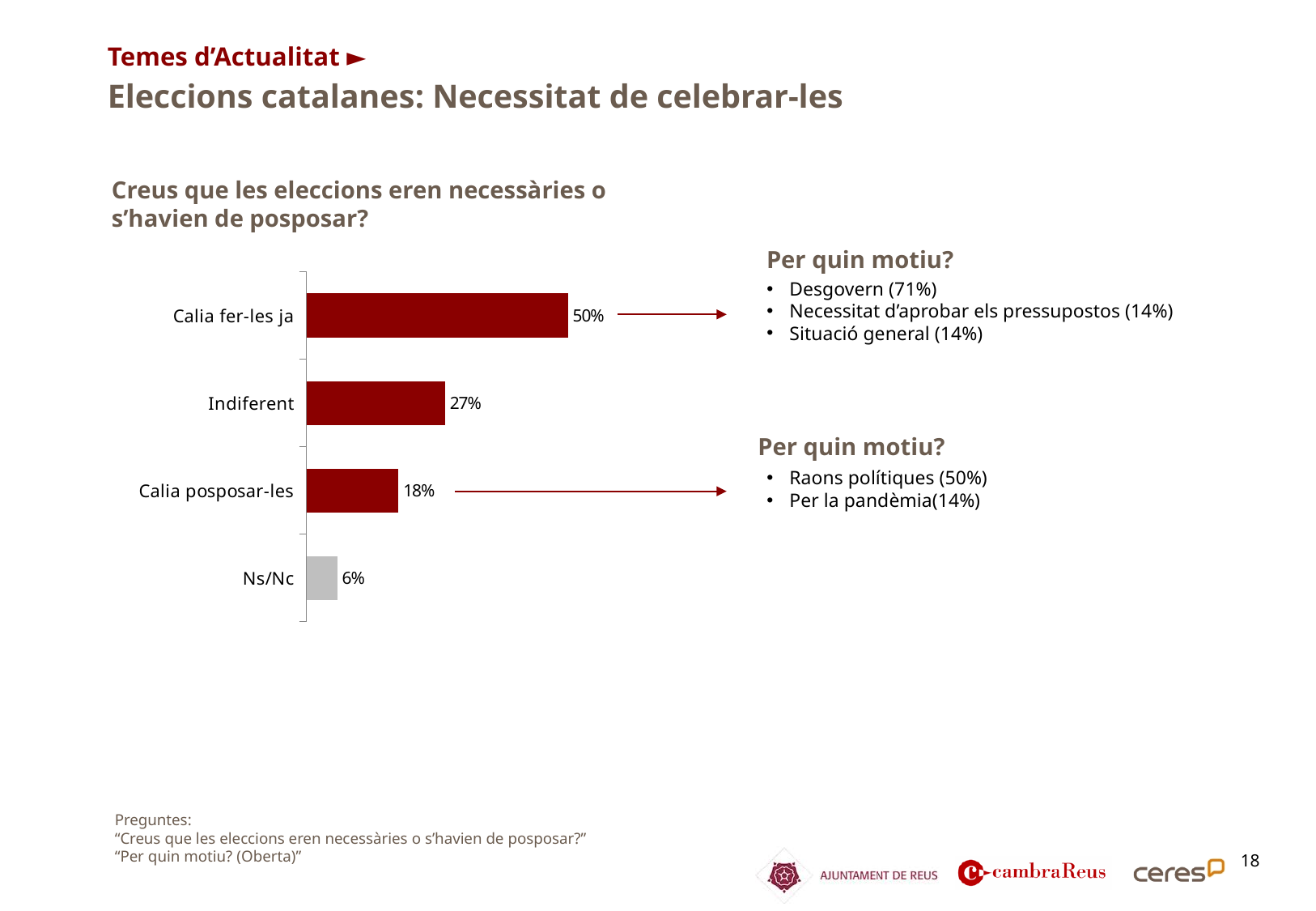
What is the difference between "Indiferent" and "Ns/Nc"? 21% What is the difference between "Calia fer-les ja" and "Calia posposar-les"? 32% Which category has the lowest value? Ns/Nc What is the value for "Indiferent"? 27% What kind of chart is shown on the slide? Bar chart Which category has the highest value? Calia fer-les ja What is the value for "Ns/Nc"? 6% How many categories does the chart show? 4 Which is larger, "Indiferent" or "Calia posposar-les"? Indiferent What is the value for "Calia posposar-les"? 18% Which bar is shown in grey rather than dark red? Ns/Nc What is the value for "Calia fer-les ja"? 50%